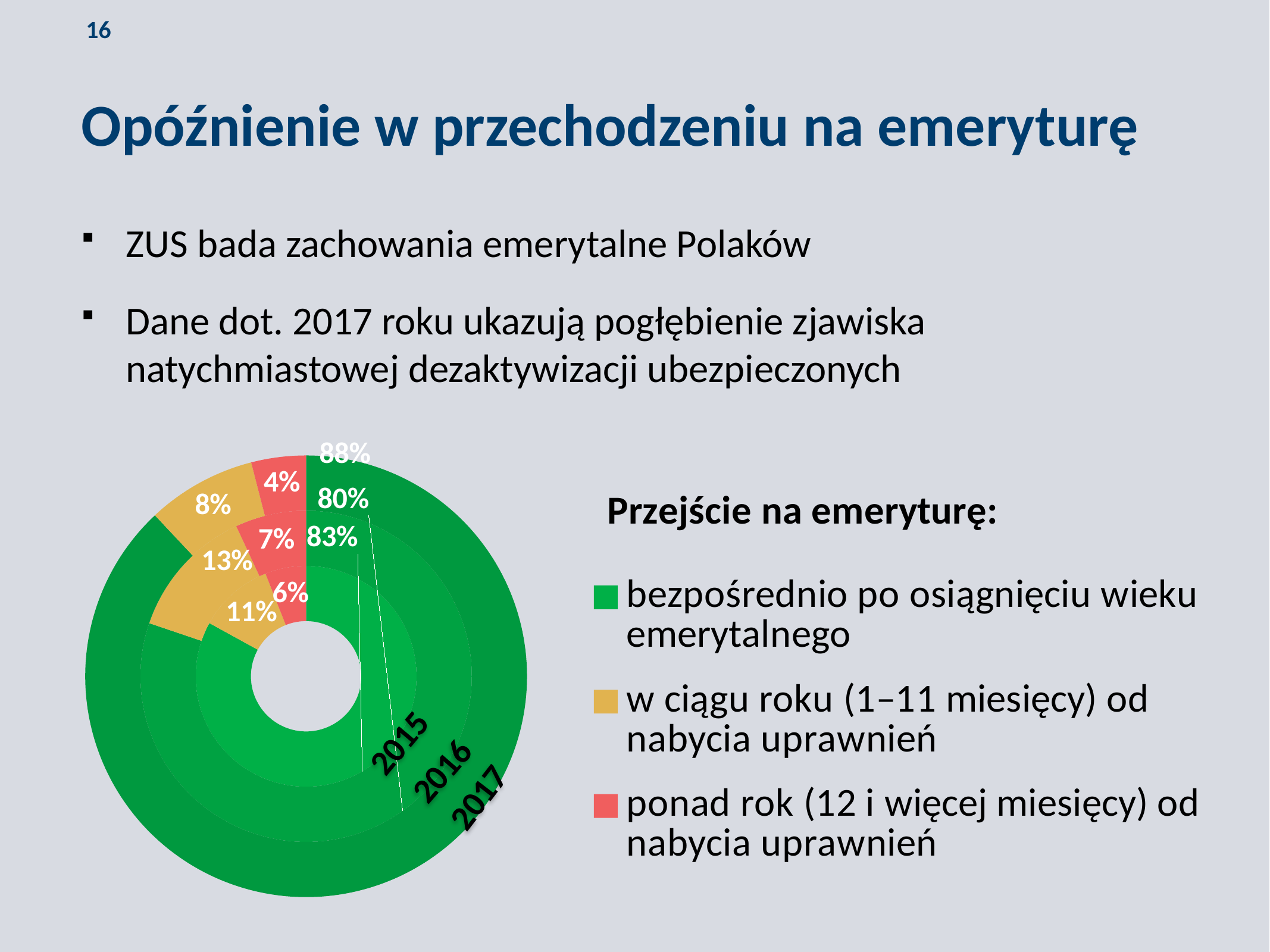
What share of people retired immediately after reaching retirement age (bezpośrednio po osiągnięciu wieku emerytalnego) in 2017? 88% What kind of chart is shown on the slide? doughnut (pie) chart By how many percentage points did the share of people retiring immediately after reaching retirement age change from 2016 to 2017? 8 percentage points In which year was the share of people retiring more than a year after acquiring rights the lowest? 2017 What share of people retired within a year (1–11 months) of acquiring rights in 2016? 13% How many series does the legend list? 3 Which colour represents retirement more than a year (12 or more months) after acquiring rights? red What share of people retired immediately after reaching retirement age in 2015? 83% How many years (rings) are shown in the chart? 3 What share of people retired more than a year (12 or more months) after acquiring rights in 2015? 6% Which is larger: the share retiring within a year (1–11 months) in 2016 or in 2017? 2016 In which year was the share of people retiring immediately after reaching retirement age the highest? 2017